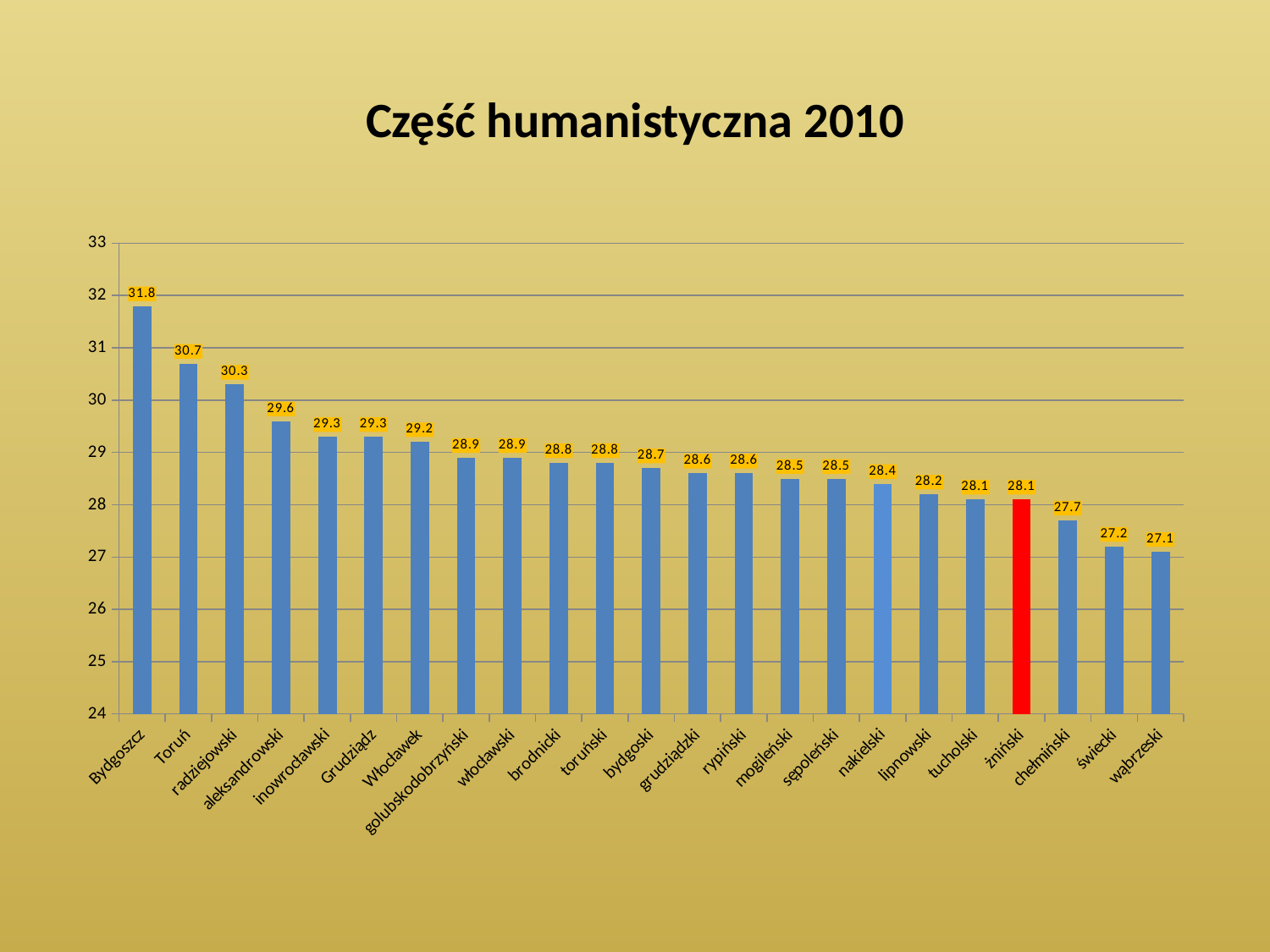
What is the difference between the values for Bydgoszcz and Toruń? 1.1 What is the difference between the values for nakielski and świecki? 1.2 What is the value for żniński? 28.1 How many categories are shown on the x axis? 23 Which category's bar is coloured red? żniński What is the value for Bydgoszcz? 31.8 Which category has the highest value? Bydgoszcz Is the value for Toruń greater or less than 30? greater Which is larger, the value for radziejowski or the value for aleksandrowski? radziejowski What is the value for chełmiński? 27.7 What kind of chart is shown on the slide? bar chart Which category has the lowest value? wąbrzeski